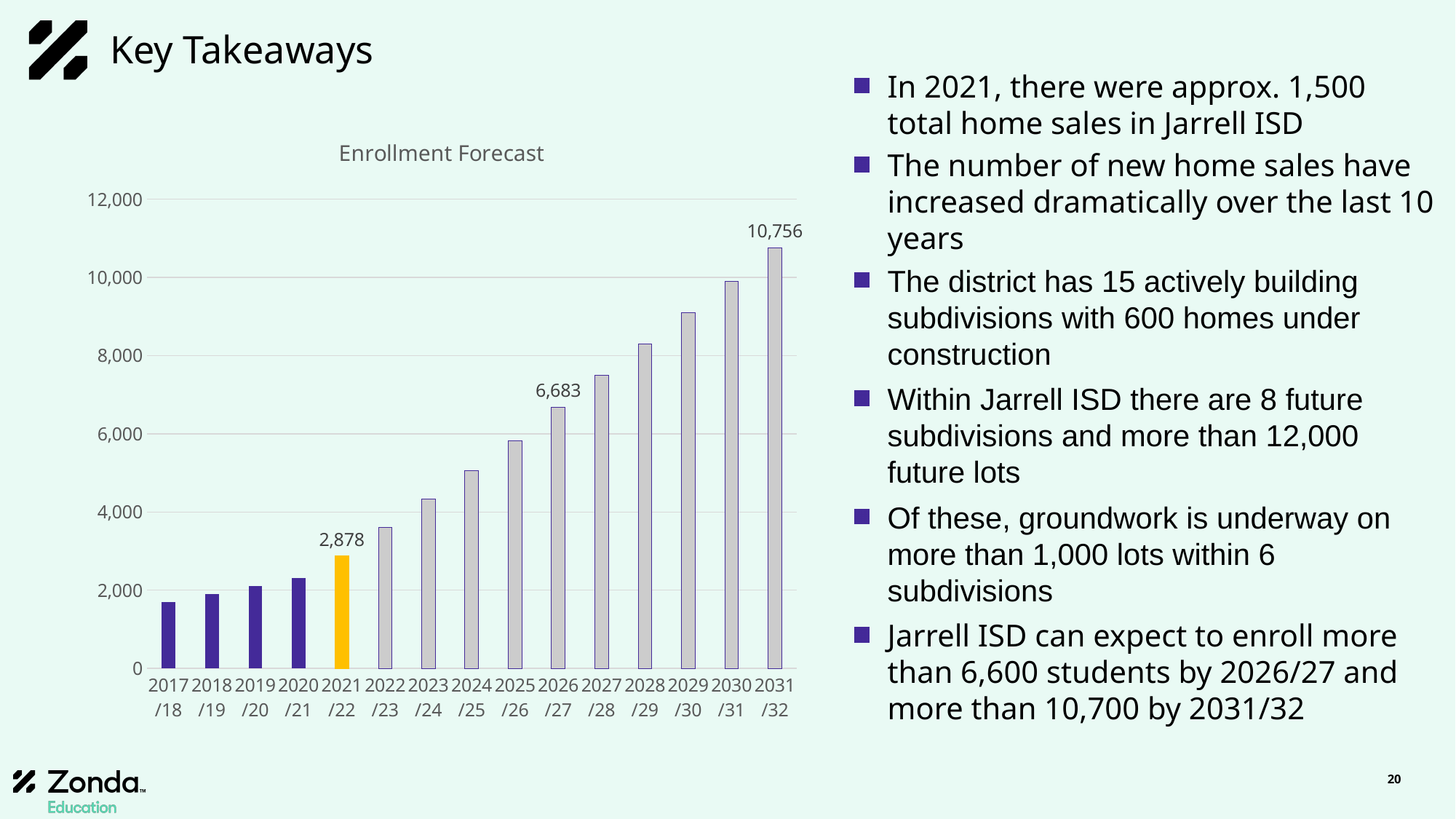
What is the difference between the enrollment for 2026/27 and 2021/22? 3,805 Do the enrollment values rise or fall from 2017/18 to 2031/32? rise What is the difference between the enrollment for 2031/32 and 2021/22? 7,878 What is the enrollment value shown for 2021/22? 2,878 What kind of chart is used to show the Enrollment Forecast? bar chart Which school year has the highest enrollment in the chart? 2031/32 Is the enrollment value for 2017/18 greater or less than 2,000? less Which school year has the lowest enrollment in the chart? 2017/18 What is the enrollment value shown for 2026/27? 6,683 What is the enrollment value shown for 2031/32? 10,756 How many school years are shown on the x axis of the chart? 15 Is the enrollment value for 2029/30 greater or less than 8,000? greater